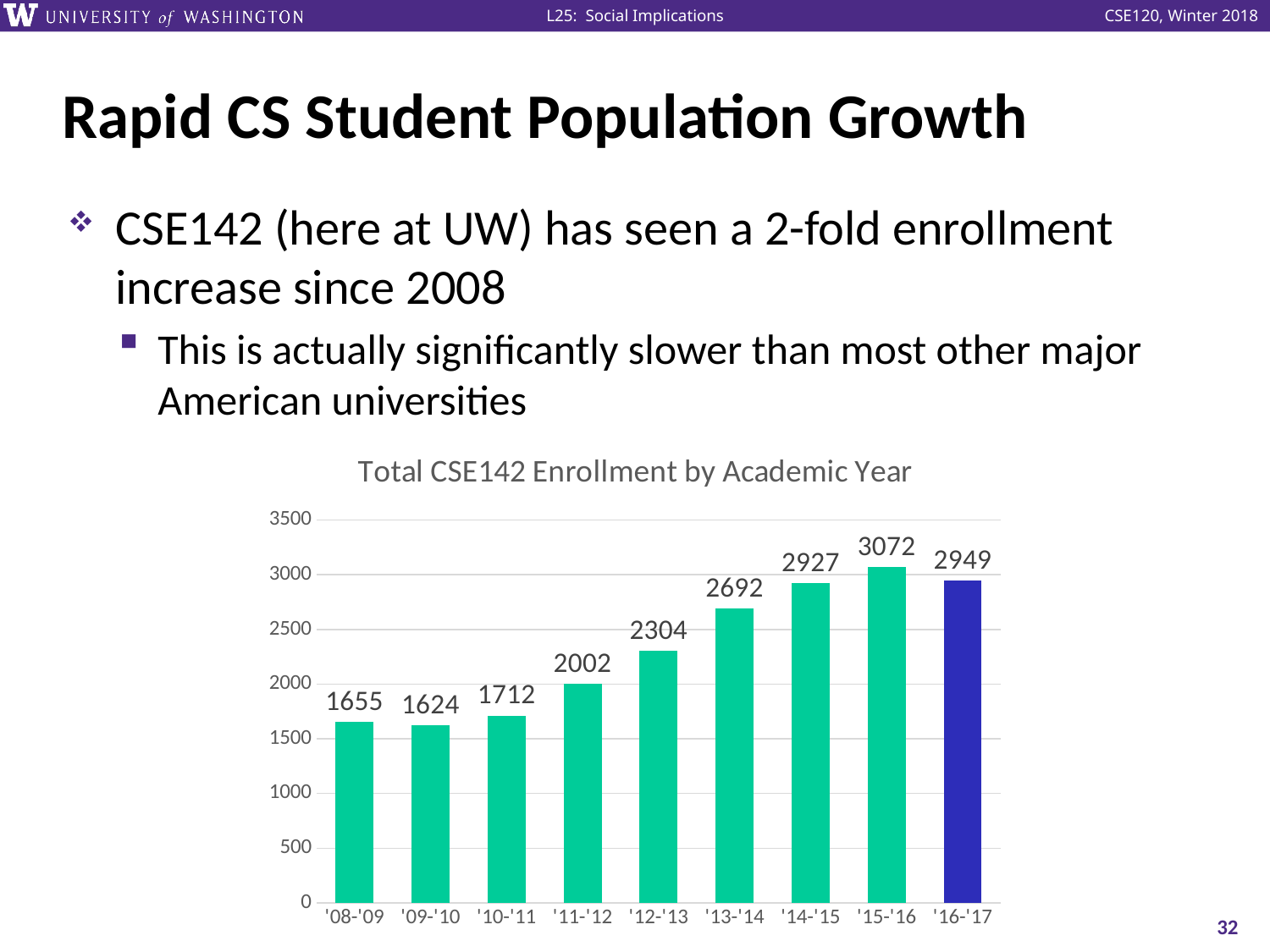
What kind of chart is used to show CSE142 enrollment by academic year? bar chart What is the total CSE142 enrollment for the '16-'17 academic year? 2949 Which academic year has higher enrollment, '12-'13 or '13-'14? '13-'14 What is the total CSE142 enrollment for the '15-'16 academic year? 3072 Which academic year has the lowest CSE142 enrollment? '09-'10 What is the title of the chart? Total CSE142 Enrollment by Academic Year Is the enrollment for '14-'15 greater or less than 3000? less How many academic years are shown on the x axis of the chart? 9 Which bar in the chart is coloured differently from the others? '16-'17 What is the total CSE142 enrollment for the '11-'12 academic year? 2002 What is the difference in enrollment between '15-'16 and '08-'09? 1417 Which academic year has the highest CSE142 enrollment? '15-'16